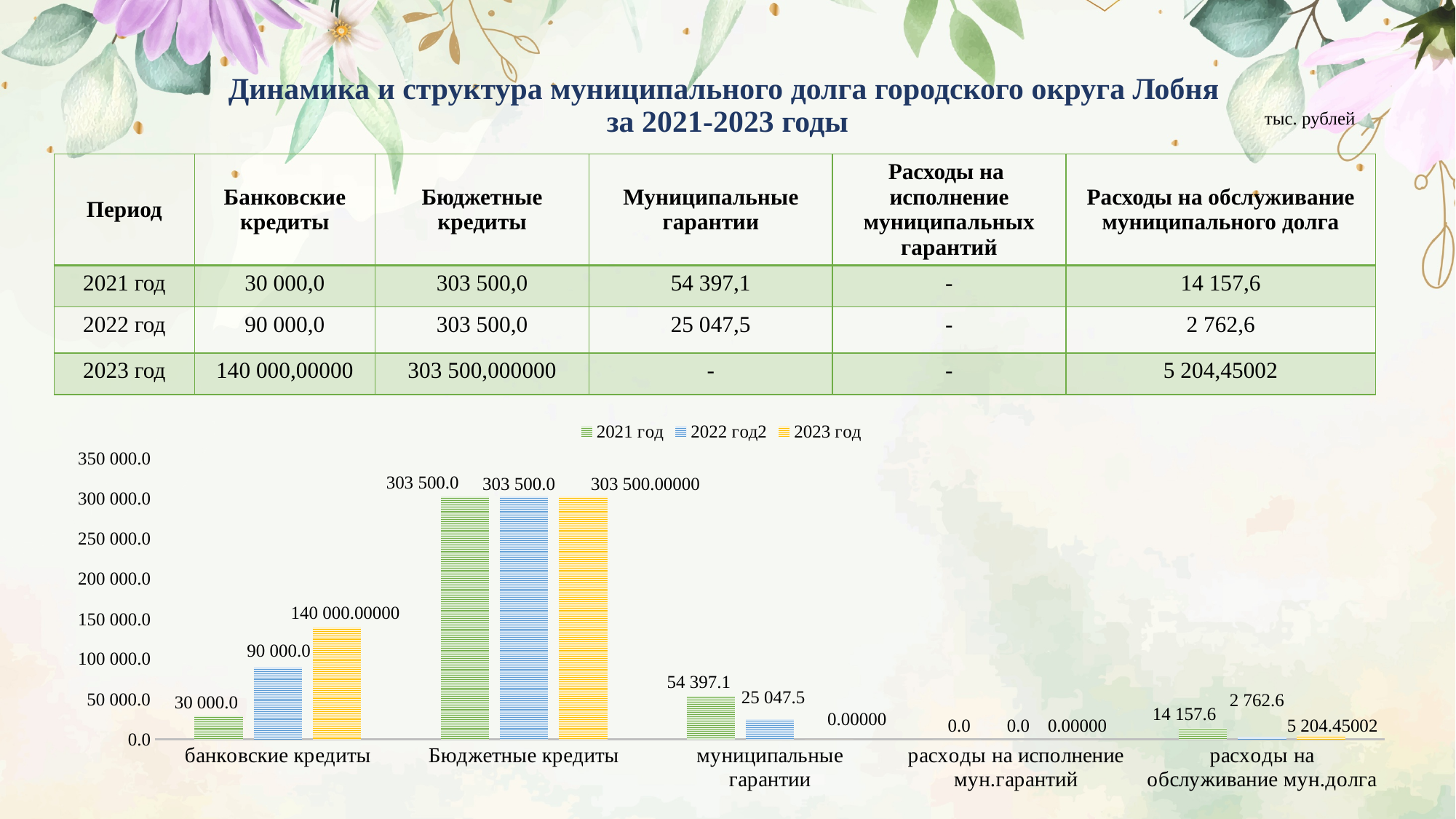
What is the difference between the 2021 год and 2022 год2 values for расходы на обслуживание мун.долга? 11 395.0 What is the difference between the 2022 год2 and 2021 год values for банковские кредиты? 60 000.0 Which category has the highest value in the 2021 год series? Бюджетные кредиты How many categories are shown along the x axis of the chart? 5 What is the value for расходы на обслуживание мун.долга in the 2023 год series? 5 204.45002 What is the value for банковские кредиты in the 2022 год2 series? 90 000.0 Is the value for банковские кредиты in the 2022 год2 series greater or less than 100 000.0? less What kind of chart is shown on the slide? bar chart How many series does the chart legend list? 3 What is the value for муниципальные гарантии in the 2021 год series? 54 397.1 Which is larger for муниципальные гарантии: the 2021 год value or the 2022 год2 value? 2021 год Do the values for банковские кредиты rise or fall from 2021 год to 2023 год? rise